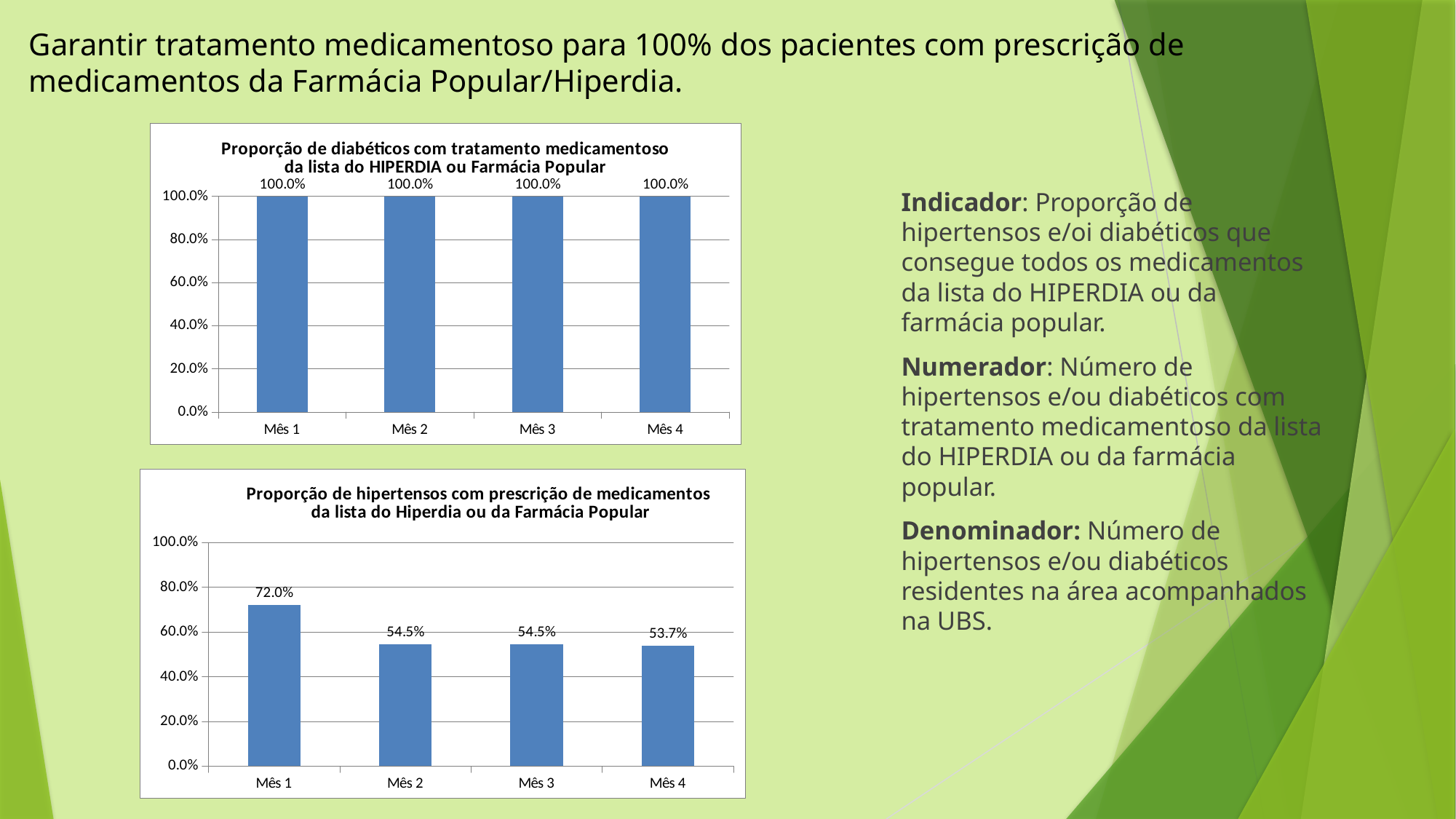
In the bottom chart (Proporção de hipertensos com prescrição de medicamentos), which month has the highest value? Mês 1 In the bottom chart (Proporção de hipertensos com prescrição de medicamentos), what is the value for Mês 1? 72.0% In the bottom chart (Proporção de hipertensos com prescrição de medicamentos), which is larger, the value for Mês 1 or the value for Mês 3? Mês 1 How many months are shown on the x axis of the top chart (Proporção de diabéticos com tratamento medicamentoso)? 4 In the bottom chart (Proporção de hipertensos com prescrição de medicamentos), is the value for Mês 2 greater or less than 60.0%? less In the bottom chart (Proporção de hipertensos com prescrição de medicamentos), what is the difference between Mês 1 and Mês 2? 17.5% In the top chart (Proporção de diabéticos com tratamento medicamentoso), what is the value for Mês 3? 100.0% What is the title of the top chart on the slide? Proporção de diabéticos com tratamento medicamentoso da lista do HIPERDIA ou Farmácia Popular In the top chart (Proporção de diabéticos com tratamento medicamentoso), what is the difference between Mês 1 and Mês 4? 0.0% In the bottom chart (Proporção de hipertensos com prescrição de medicamentos), do the values rise or fall from Mês 1 to Mês 4? Fall In the bottom chart (Proporção de hipertensos com prescrição de medicamentos), what is the value for Mês 4? 53.7% What kind of chart is the bottom chart (Proporção de hipertensos com prescrição de medicamentos)? Bar chart